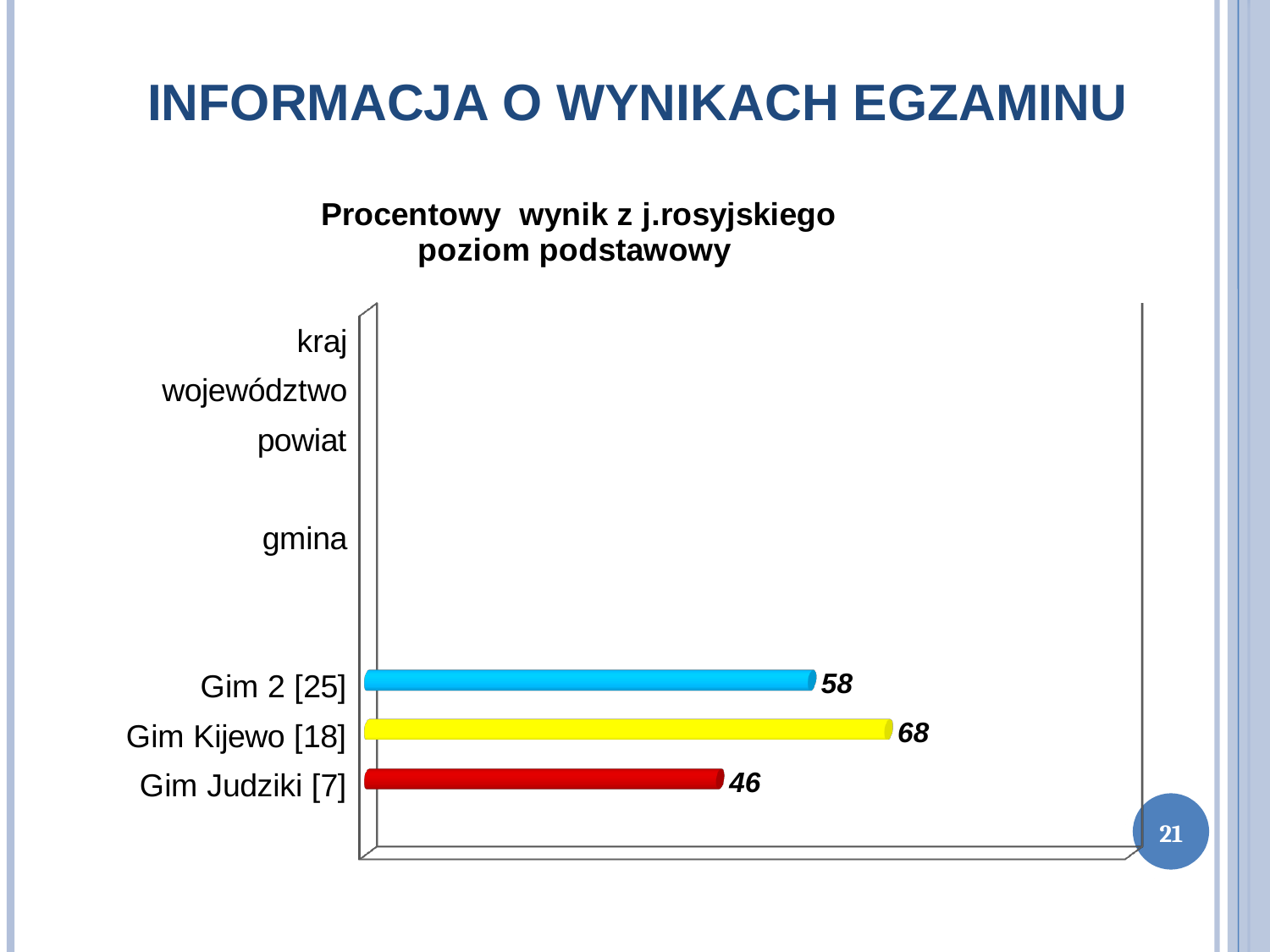
Which is larger, the value for Gim 2 [25] or the value for Gim Judziki [7]? Gim 2 [25] How many bars are plotted on the chart? 3 What is the difference between the values for Gim Kijewo [18] and Gim 2 [25]? 10 Which category has the lowest plotted value? Gim Judziki [7] What is the title of the chart? Procentowy wynik z j.rosyjskiego poziom podstawowy What is the difference between the values for Gim Kijewo [18] and Gim Judziki [7]? 22 What is the value for Gim Judziki [7]? 46 What is the value for Gim Kijewo [18]? 68 Which category has the highest plotted value? Gim Kijewo [18] What is the value for Gim 2 [25]? 58 How many category labels are listed on the vertical axis? 7 What kind of chart is shown on the slide? Bar chart